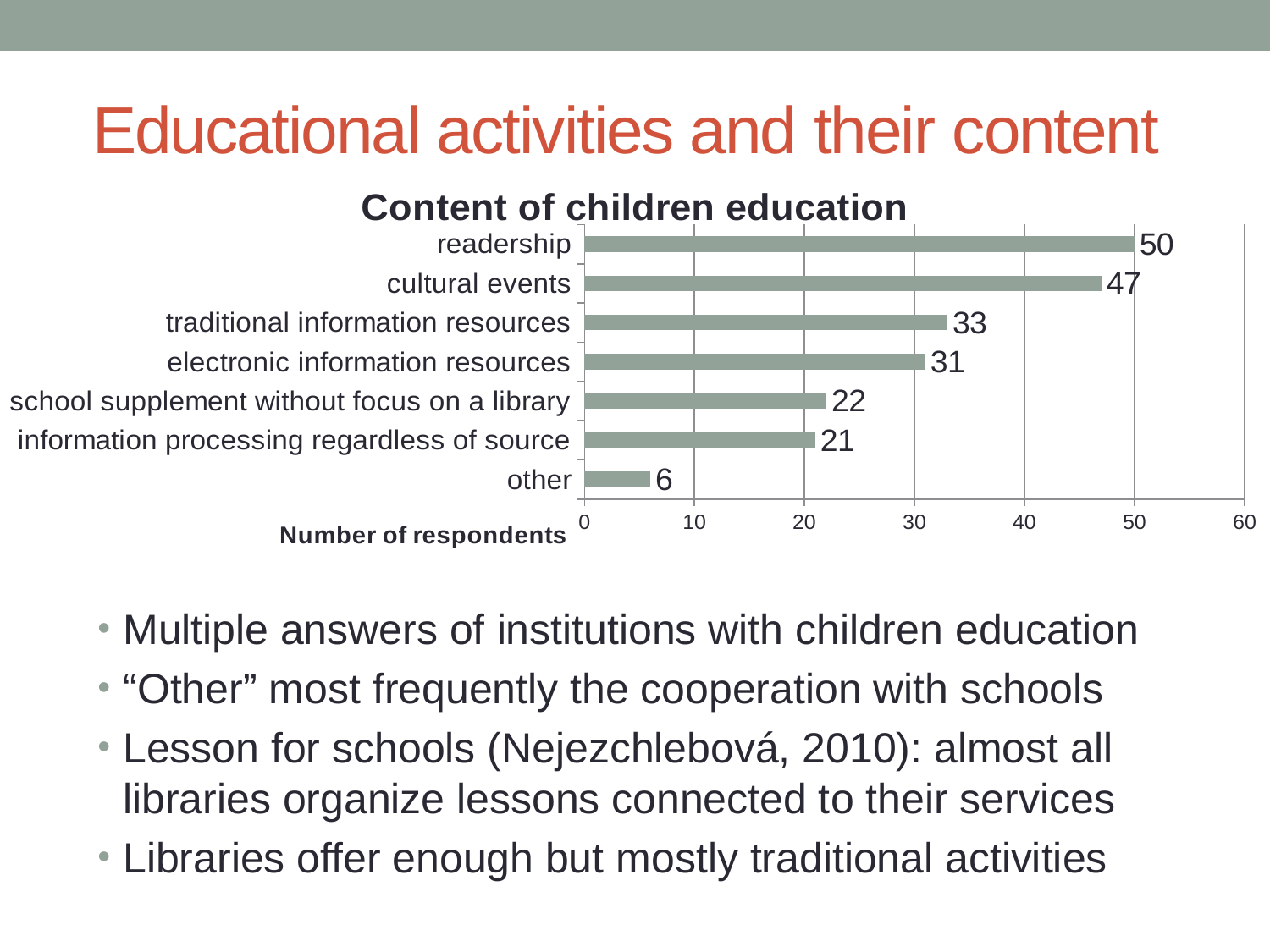
What is the difference in respondents between traditional information resources and other? 27 What is the difference in respondents between readership and cultural events? 3 What is the number of respondents for information processing regardless of source? 21 Which category has the lowest number of respondents? other Which category has the highest number of respondents? readership Which has more respondents, school supplement without focus on a library or electronic information resources? electronic information resources What is the number of respondents for electronic information resources? 31 What is the number of respondents for readership? 50 Is the value for cultural events greater or less than 40? greater What kind of chart is shown on the slide? bar chart What is the title of the chart? Content of children education How many categories are shown in the chart? 7